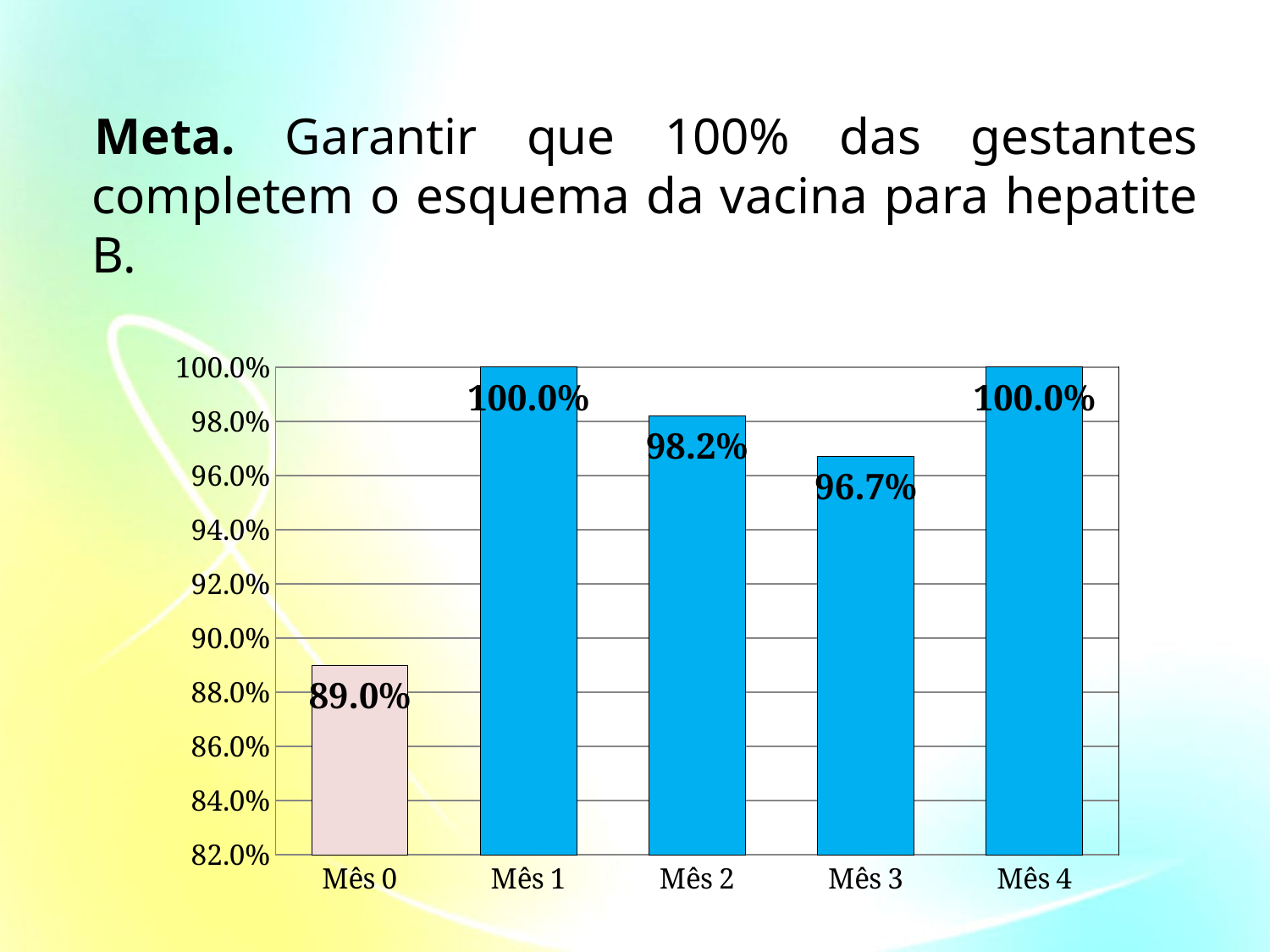
What is the value for Mês 3? 96.7% What is the value for Mês 2? 98.2% How many months are shown on the x axis? 5 Which bar has a different colour from the others? Mês 0 Which month has the lowest value? Mês 0 Which is larger, the value for Mês 2 or the value for Mês 3? Mês 2 Is the value for Mês 0 greater or less than 90.0%? less What is the difference between the values for Mês 1 and Mês 0? 11.0% What is the difference between the values for Mês 2 and Mês 3? 1.5% What kind of chart is shown on the slide? bar chart What is the value for Mês 4? 100.0% What is the value for Mês 0? 89.0%